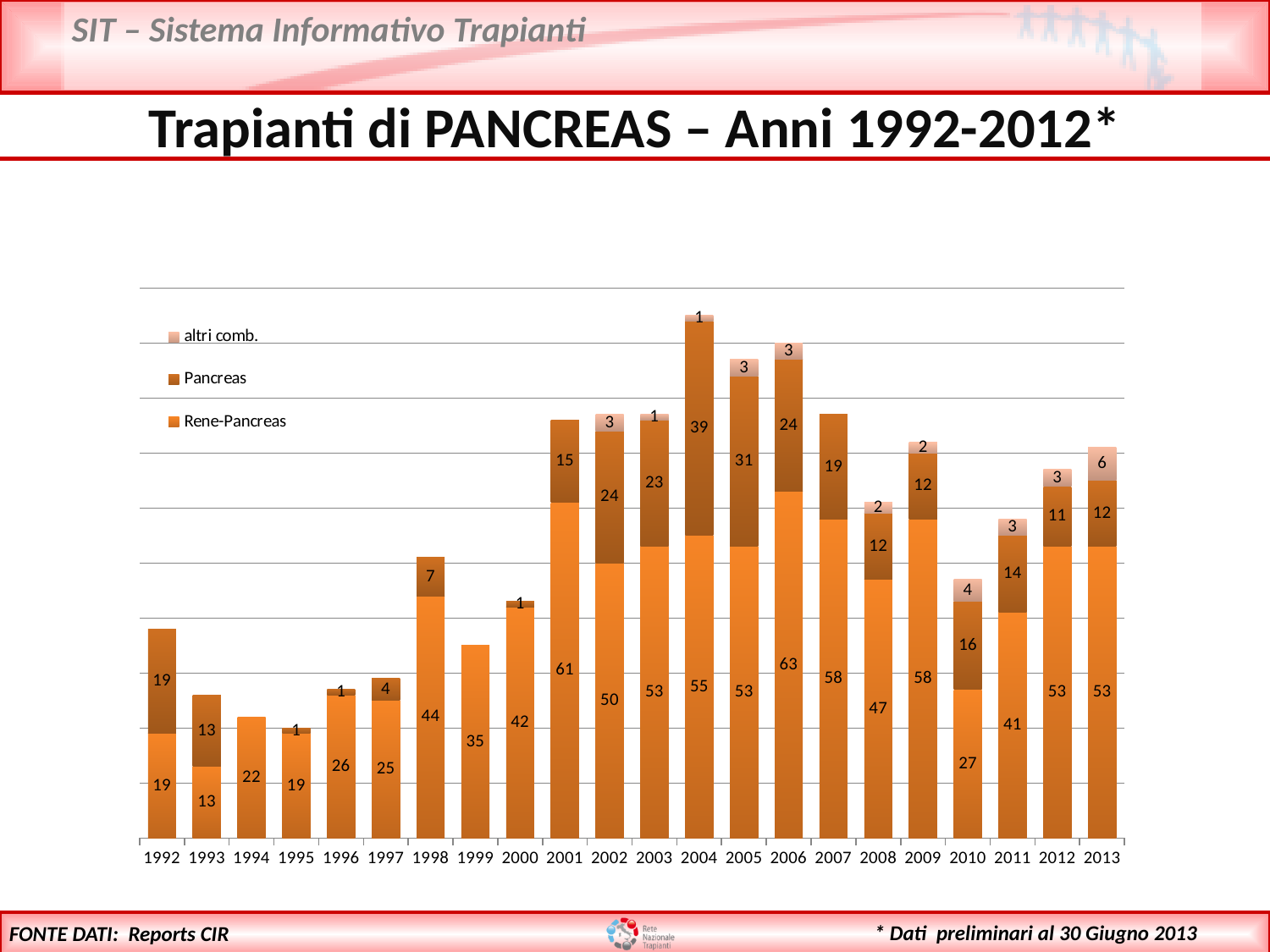
How many series does the legend list? 3 What is the Rene-Pancreas value for 2006? 63 Which is larger, the Pancreas value for 2002 or for 2007? 2002 Which year has the highest Rene-Pancreas value? 2006 What is the altri comb. value for 2013? 6 Which year has the lowest Rene-Pancreas value? 1993 Which year has the highest Pancreas value? 2004 What is the total of the stacked bar for 2013? 71 What is the Pancreas value for 2004? 39 What is the total of the stacked bar for 2004? 95 How many years are shown on the x axis? 22 What is the difference between the Rene-Pancreas values for 2001 and 2010? 34